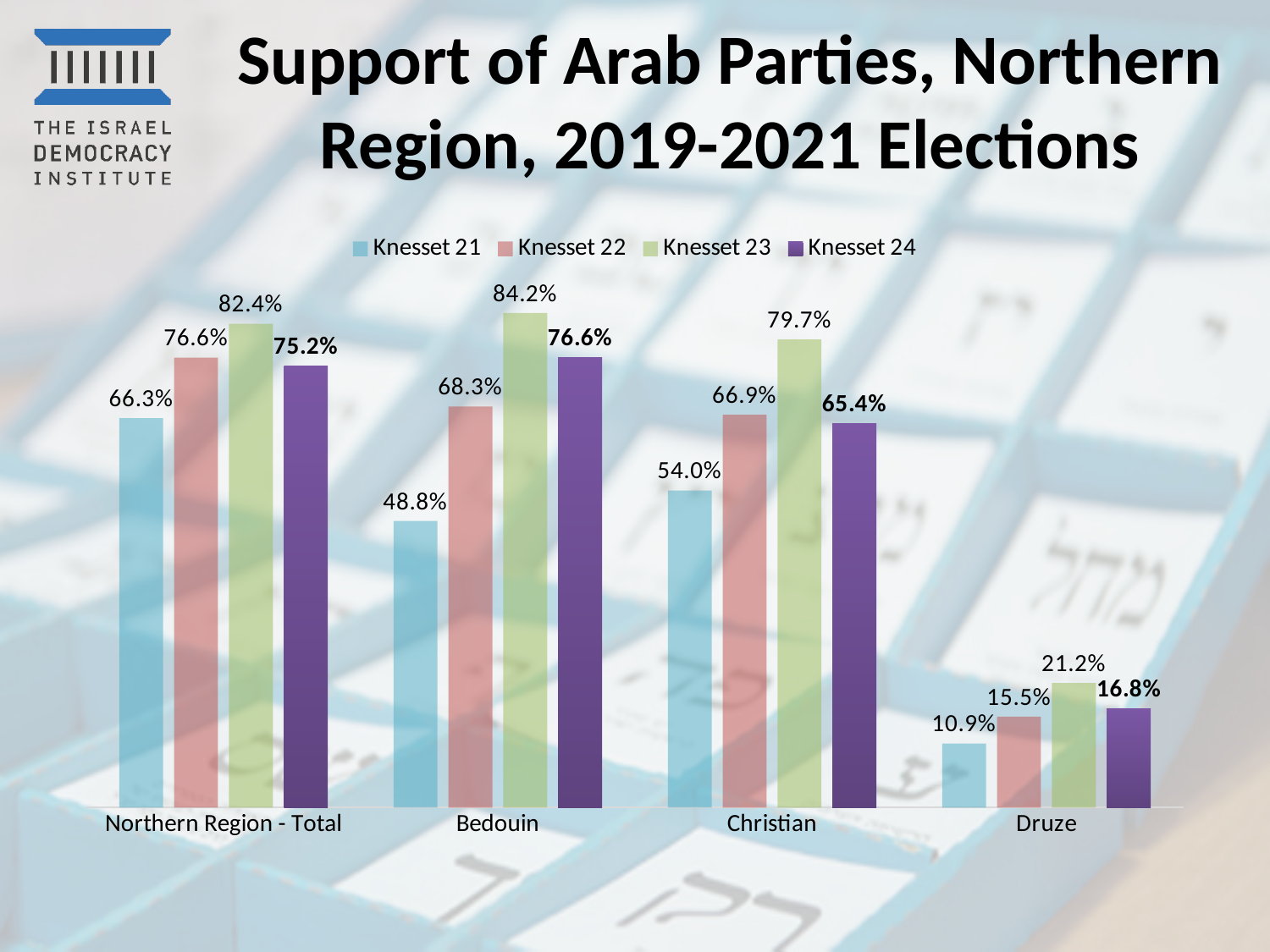
Which category has the lowest Knesset 22 value? Druze What is the Knesset 24 value for Bedouin? 76.6% Which is larger: the Knesset 22 value for Christian or the Knesset 22 value for Bedouin? Bedouin What is the difference between the Knesset 23 and Knesset 21 values for Bedouin? 35.4% Which category has the highest Knesset 23 value? Bedouin How many categories are shown on the x axis? 4 How many series does the legend list? 4 Which series is shown in purple in the legend? Knesset 24 What kind of chart is shown on the slide? Bar chart What is the difference between the Knesset 24 values for Northern Region - Total and Druze? 58.4% What is the Knesset 21 value for Christian? 54.0% What is the Knesset 23 value for Druze? 21.2%